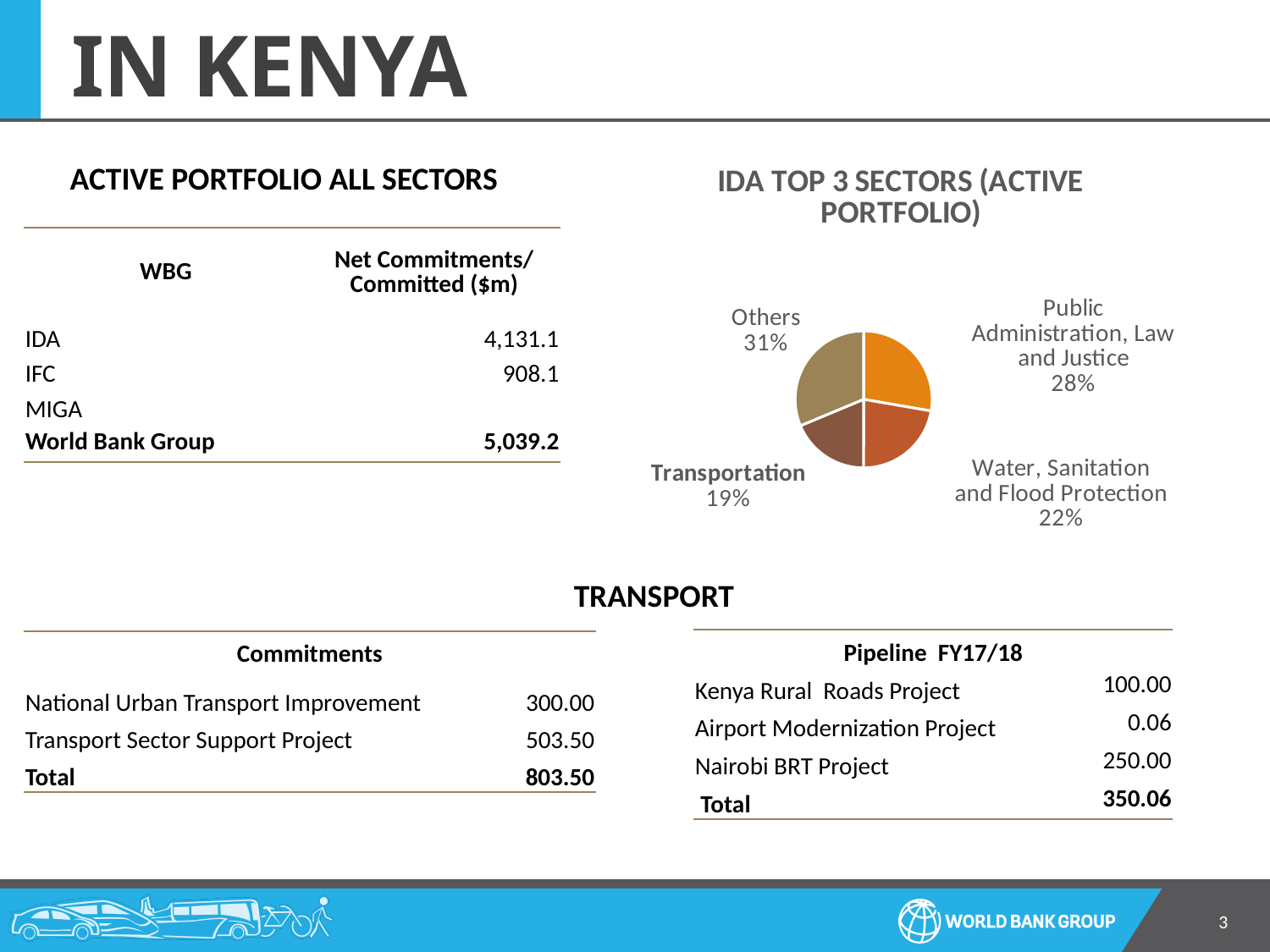
In the pie chart, what is the combined share of the three named sectors (excluding Others)? 69% In the pie chart, what is the difference in percentage points between Public Administration, Law and Justice and Transportation? 9 In the pie chart, what share is labelled for Others? 31% Which slice of the pie chart has the smallest share? Transportation Which slice of the pie chart has the largest share? Others In the pie chart, which is larger: Water, Sanitation and Flood Protection or Transportation? Water, Sanitation and Flood Protection In the pie chart, what share is labelled for Public Administration, Law and Justice? 28% What type of chart is shown under the title "IDA TOP 3 SECTORS (ACTIVE PORTFOLIO)"? Pie chart What is the title of the pie chart on the slide? IDA TOP 3 SECTORS (ACTIVE PORTFOLIO) In the pie chart, what share is labelled for Transportation? 19% In the pie chart, what share is labelled for Water, Sanitation and Flood Protection? 22% How many slices does the pie chart have? 4